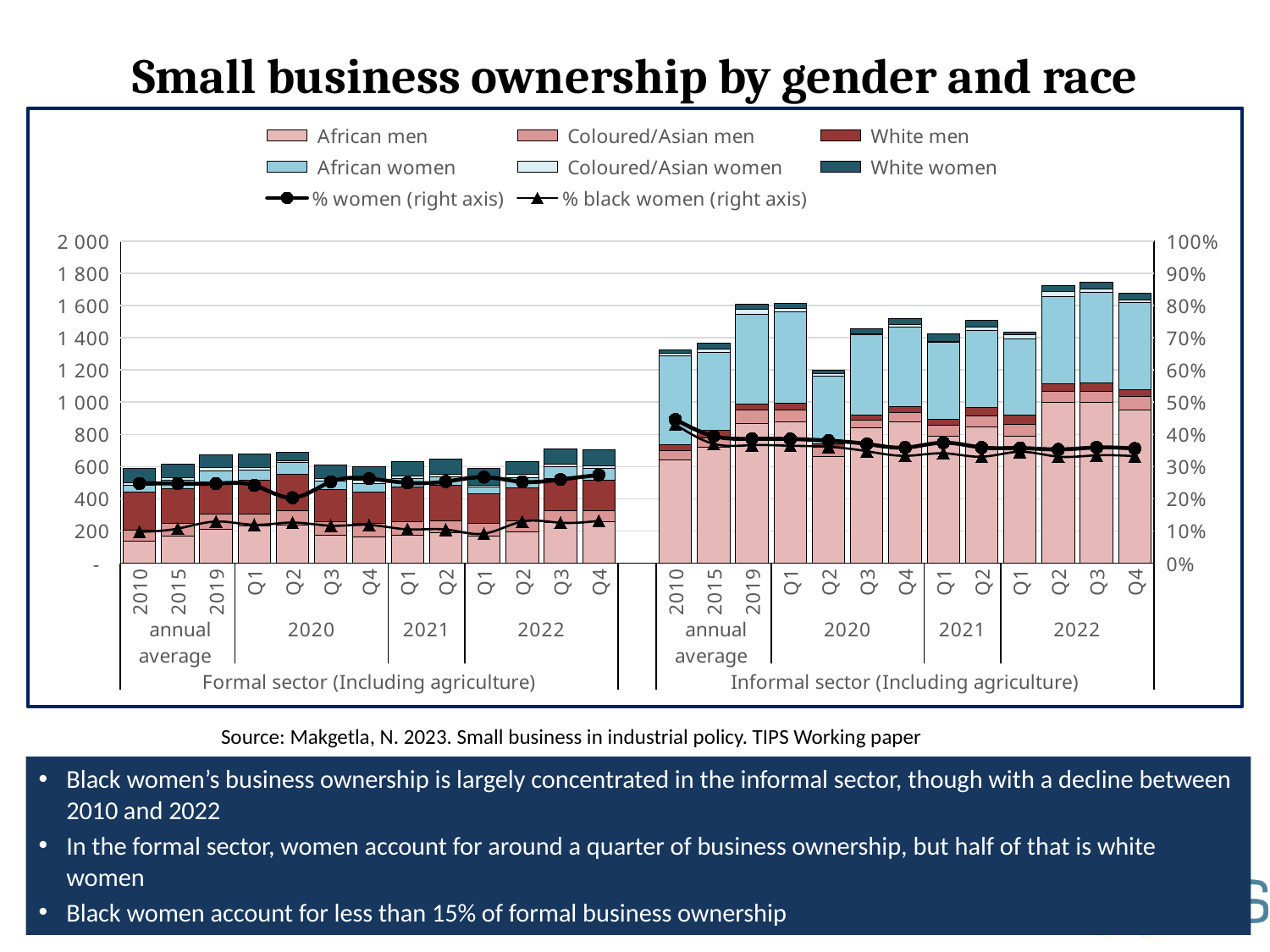
How many bars are plotted for the Informal sector (Including agriculture)? 13 What kind of chart is shown on the slide? Stacked bar chart with line series Which period has the lowest total bar in the Informal sector? 2020 Q2 Which is larger in the Informal sector, the total bar for 2020 Q1 or 2020 Q2? 2020 Q1 Which axis do the '% women' and '% black women' series use? Right axis Which is larger, the total bar for 2022 Q3 in the Formal sector or in the Informal sector? Informal sector Is the total bar for 2022 Q3 in the Informal sector greater or less than 1 600? greater What is the title of the chart? Small business ownership by gender and race Is the total bar for the 2010 annual average in the Formal sector greater or less than 800? less How many series does the legend list? 8 Is the '% black women' value for the 2010 annual average in the Formal sector greater or less than 20%? less